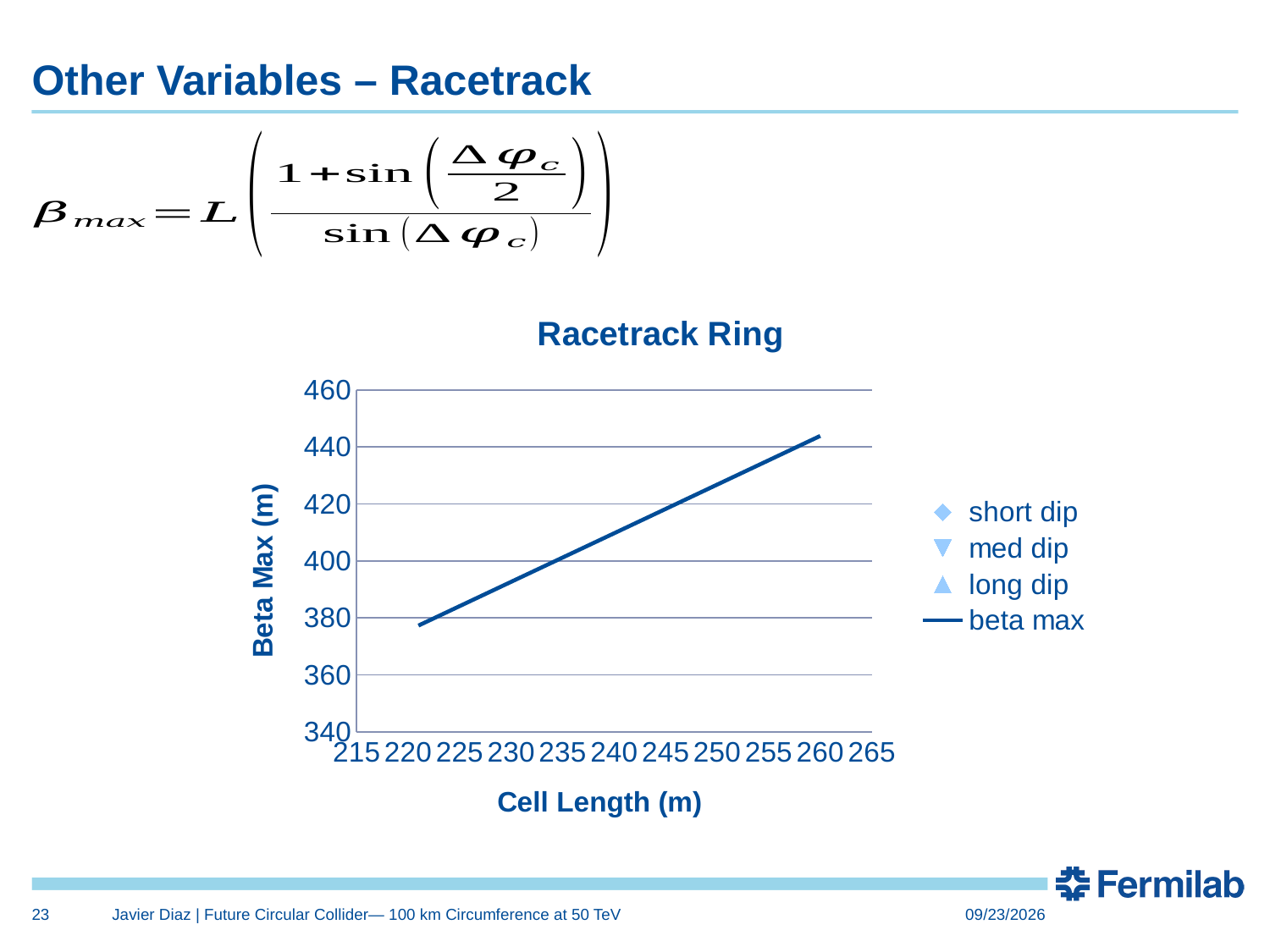
Is the beta max value at a cell length of 235 m greater or less than 420? less What is the label of the y axis? Beta Max (m) Which is larger, the beta max value at a cell length of 225 m or at 255 m? 255 m Is the beta max value at a cell length of 250 m greater or less than 420? greater What is the title of the chart? Racetrack Ring How many series does the chart's legend list? 4 Is the beta max value at a cell length of 240 m greater or less than 400? greater What kind of chart is shown under the title "Racetrack Ring"? line chart Does the beta max line rise or fall as cell length increases along the x axis? rises